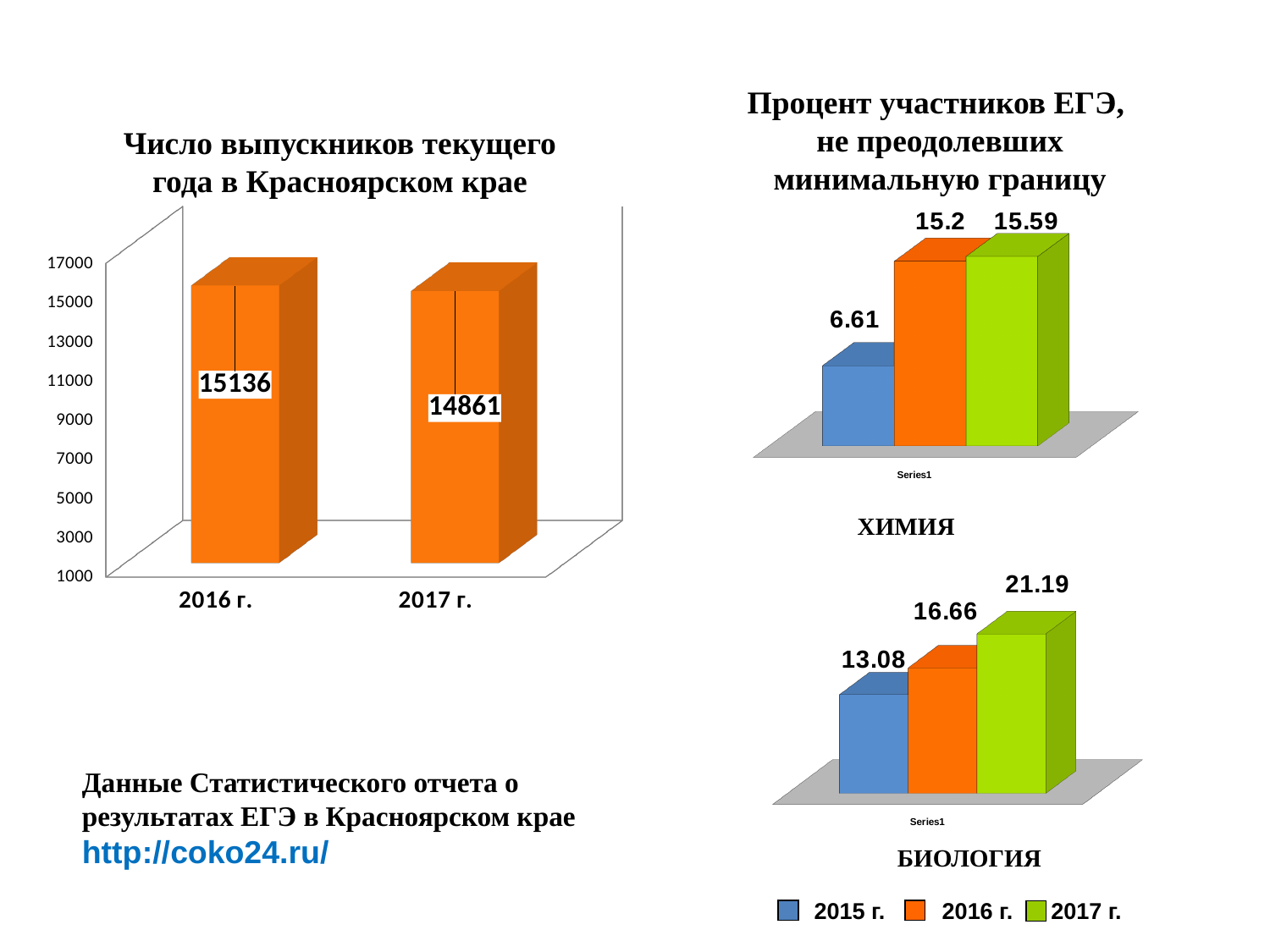
In the БИОЛОГИЯ chart, what is the value for 2016 г.? 16.66 In the ХИМИЯ chart, which year has the lowest value? 2015 г. In the chart 'Число выпускников текущего года в Красноярском крае', what is the difference between the 2016 г. and 2017 г. values? 275 In the ХИМИЯ chart, what is the value for 2015 г.? 6.61 In the ХИМИЯ chart, what is the value for 2017 г.? 15.59 In the chart 'Число выпускников текущего года в Красноярском крае', what is the value for 2016 г.? 15136 In the chart 'Число выпускников текущего года в Красноярском крае', what is the value for 2017 г.? 14861 How many series does the legend below the БИОЛОГИЯ chart list? 3 What kind of chart is 'Число выпускников текущего года в Красноярском крае'? bar chart In the chart 'Число выпускников текущего года в Красноярском крае', do the values rise or fall from 2016 г. to 2017 г.? fall In the БИОЛОГИЯ chart, what is the difference between the 2017 г. and 2015 г. values? 8.11 In the БИОЛОГИЯ chart, which year has the highest value? 2017 г.